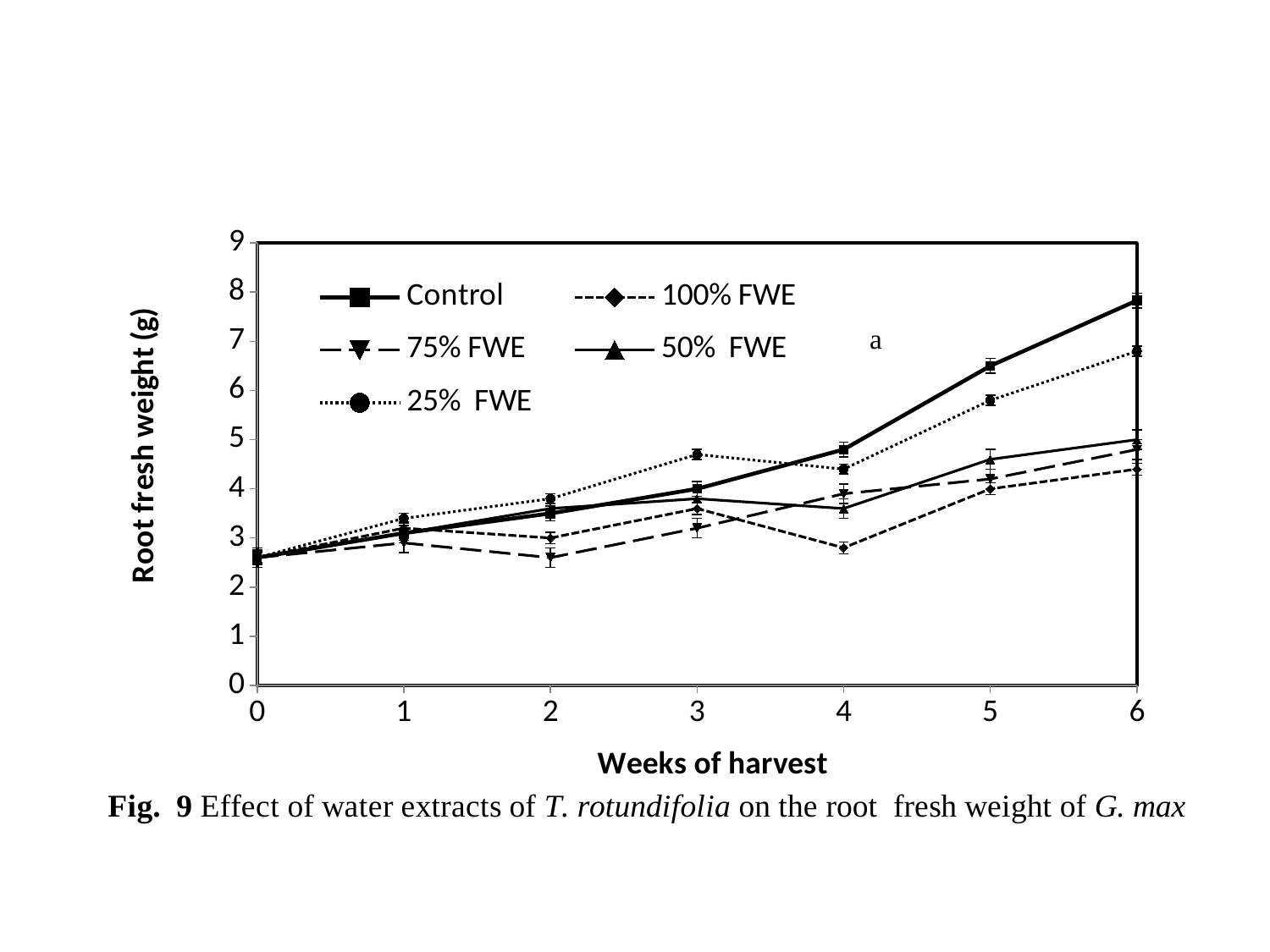
Is the value for Control at week 6 greater or less than 7? greater Which series has the highest root fresh weight at week 6? Control At week 5, which is larger: 25% FWE or 50% FWE? 25% FWE What is the label of the y axis? Root fresh weight (g) How many series does the legend list? 5 Is the value for 25% FWE at week 6 greater or less than 6? greater Which series has the highest root fresh weight at week 3? 25% FWE How many weeks of harvest are plotted along the x axis? 7 Does the Control series rise or fall from week 0 to week 6? rise Which series has the lowest root fresh weight at week 4? 100% FWE Is the value for 100% FWE at week 4 greater or less than 3? less What kind of chart is shown on the slide? line chart